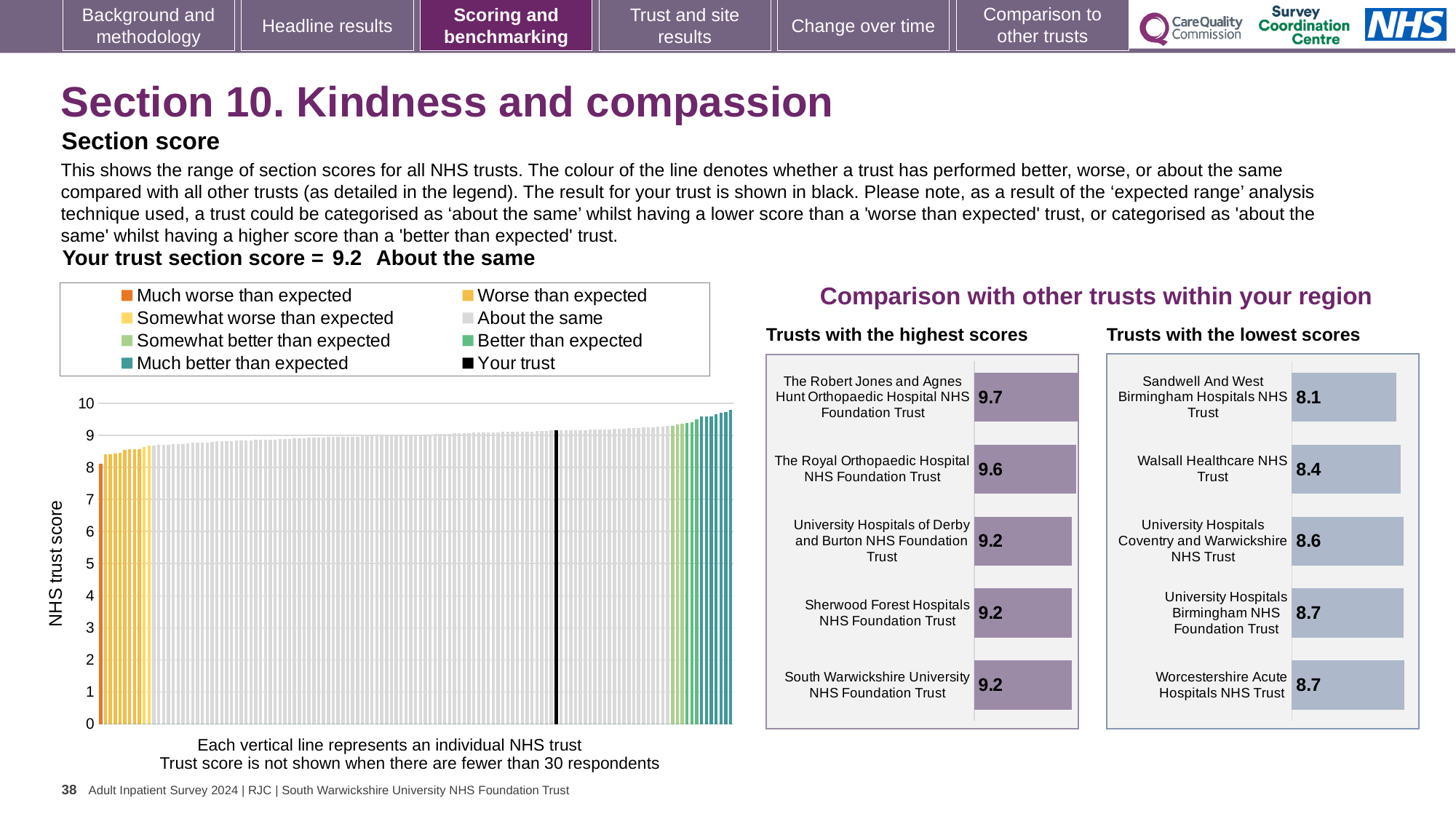
In the 'Trusts with the lowest scores' chart, which has the larger score: Walsall Healthcare NHS Trust or Worcestershire Acute Hospitals NHS Trust? Worcestershire Acute Hospitals NHS Trust In the 'Trusts with the lowest scores' chart, which trust has the lowest score? Sandwell And West Birmingham Hospitals NHS Trust In the 'Trusts with the highest scores' chart, what is the score for The Royal Orthopaedic Hospital NHS Foundation Trust? 9.6 In the 'Trusts with the highest scores' chart, how many trusts are listed? 5 In the large chart on the left, what is the highest value shown on the y axis? 10 What kind of chart is the large chart on the left showing NHS trust scores? bar chart In the 'Trusts with the highest scores' chart, what is the difference between the scores of The Robert Jones and Agnes Hunt Orthopaedic Hospital NHS Foundation Trust and Sherwood Forest Hospitals NHS Foundation Trust? 0.5 In the 'Trusts with the lowest scores' chart, what is the score for University Hospitals Coventry and Warwickshire NHS Trust? 8.6 In the large chart on the left, do the trust scores rise or fall from left to right? rise In the large chart on the left, is the value of the leftmost bar greater or less than 9? less In the 'Trusts with the highest scores' chart, which trust has the highest score? The Robert Jones and Agnes Hunt Orthopaedic Hospital NHS Foundation Trust In the large chart on the left, how many entries does the legend list? 8